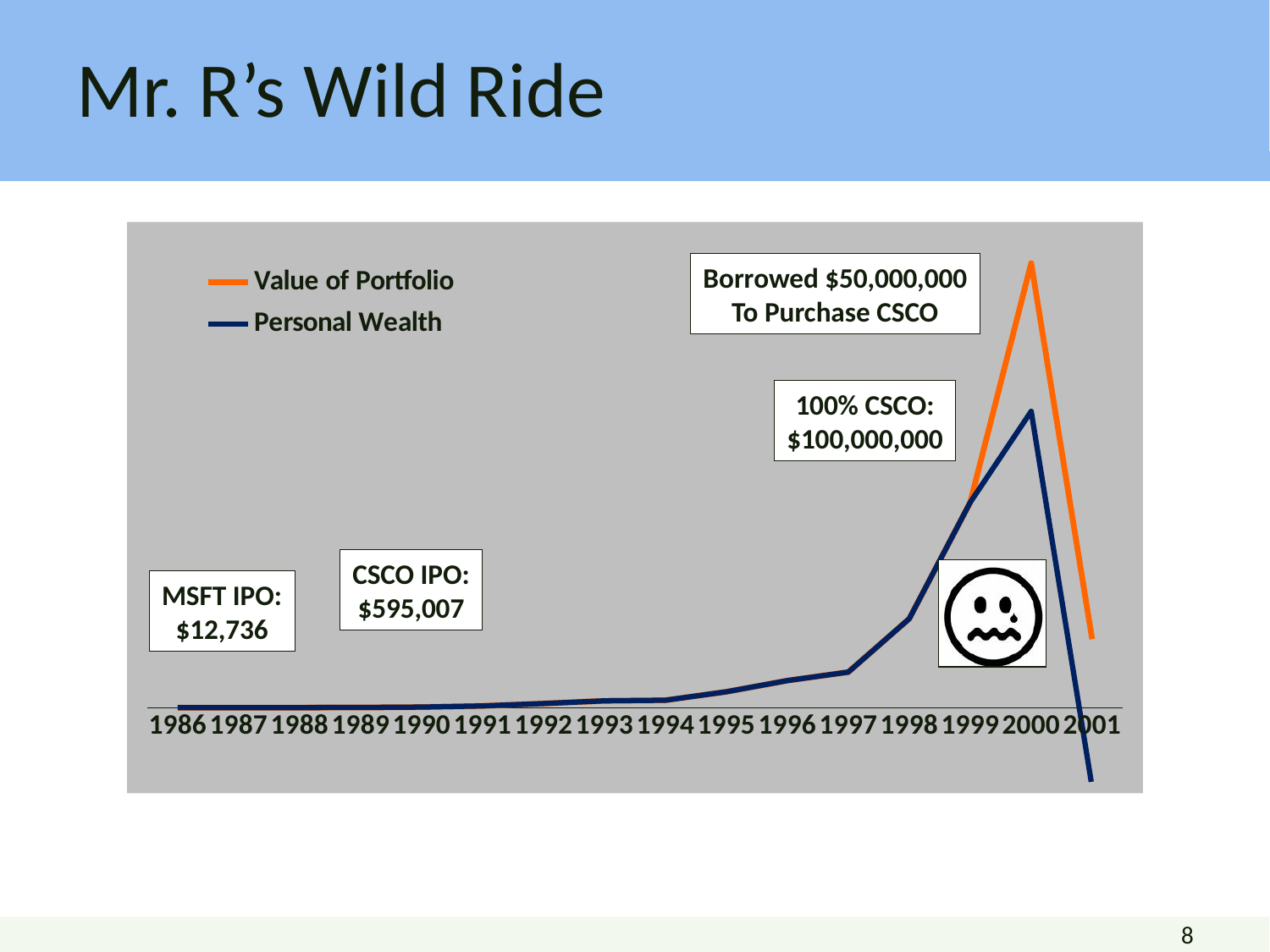
Which series is drawn in orange? Value of Portfolio What is the title of the slide containing the chart? Mr. R's Wild Ride What kind of chart is shown on the slide? line chart Is the Personal Wealth value higher in 1999 or in 2000? 2000 In 2000, which series is higher: Value of Portfolio or Personal Wealth? Value of Portfolio How many series does the legend list? 2 In which year does the Personal Wealth line reach its highest point? 2000 In which year is the Personal Wealth line at its lowest point? 2001 Do the lines rise or fall from 2000 to 2001? fall Do the lines rise or fall from 1986 to 2000? rise In which year does the Value of Portfolio line reach its highest point? 2000 How many years are shown along the x axis? 16